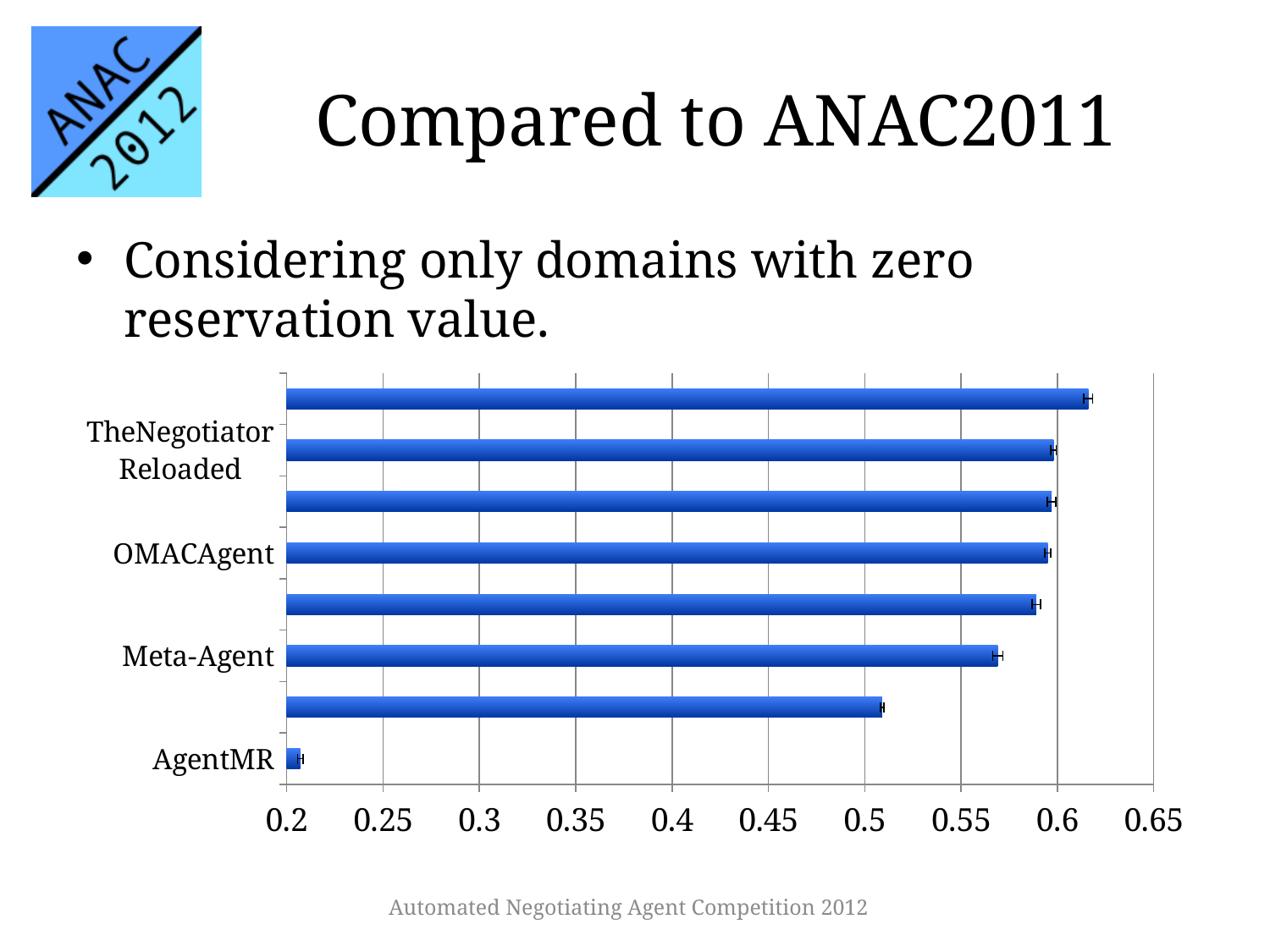
Is the value for AgentMR greater or less than 0.25? less What colour are the bars in the chart? blue Is the value for TheNegotiator Reloaded greater or less than 0.5? greater Is the value for Meta-Agent greater or less than 0.6? less How many bars are plotted in the chart? 8 Which category has the lowest value in the chart? AgentMR What kind of chart is shown on the slide? bar chart Which is larger, the value for Meta-Agent or the value for AgentMR? Meta-Agent Which is larger, the value for OMACAgent or the value for Meta-Agent? OMACAgent What is the highest value shown on the horizontal axis of the chart? 0.65